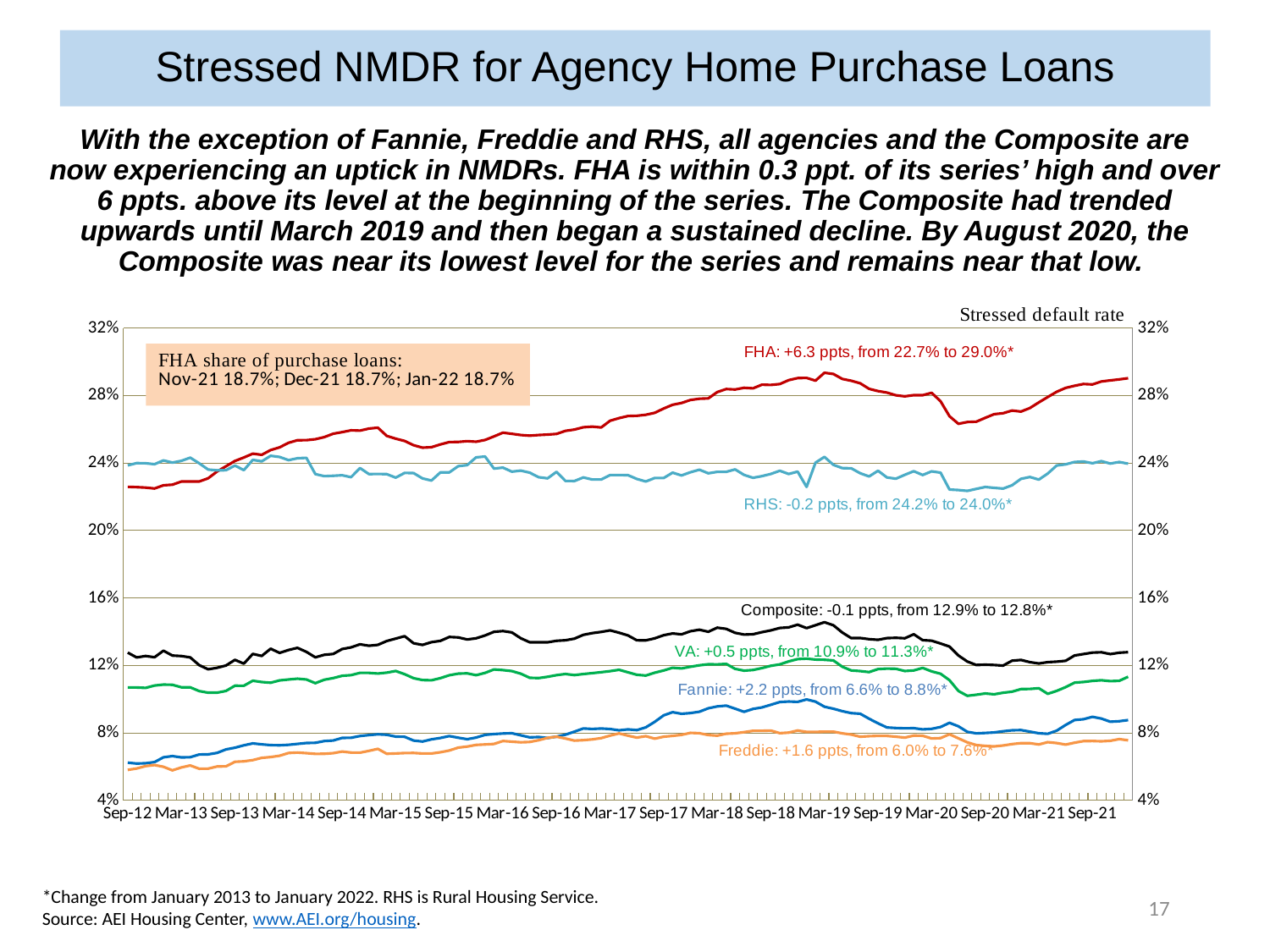
What is the difference between the FHA and RHS stressed default rates in January 2022, using the annotated values? 5.0 ppts According to the chart annotation, what was the Freddie stressed default rate in January 2013? 6.0% According to the chart annotation, what was the FHA stressed default rate in January 2022? 29.0% Does the FHA line generally rise or fall from the start to the end of the series? rise Is the FHA stressed default rate at the end of the series greater or less than 28%? greater What FHA share of purchase loans is shown for Jan-22 in the text box on the chart? 18.7% By how many percentage points did the Fannie stressed default rate change from January 2013 to January 2022, per the annotation? +2.2 ppts In January 2022, which is larger: the Fannie stressed default rate or the Freddie stressed default rate? Fannie What kind of chart is shown on the slide? line chart How many series are plotted on the chart? 6 Which series has the lowest stressed default rate at the end of the chart? Freddie Which series has the highest stressed default rate at the end of the chart? FHA